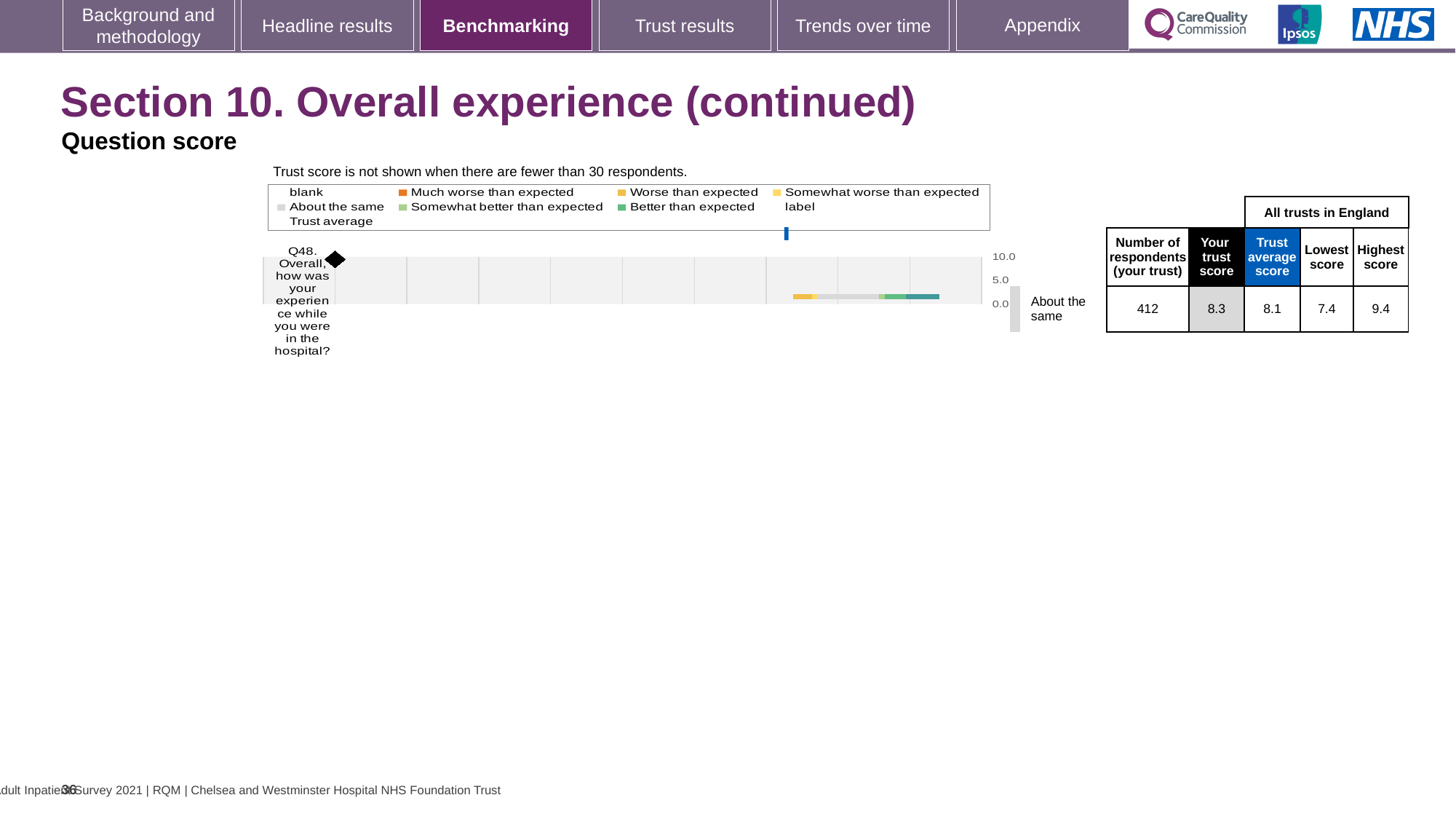
What is the difference between the trust score and the trust average score for Q48? 0.2 Which is larger for Q48, the trust score or the trust average score? trust score What is the lowest score across all trusts in England for Q48? 7.4 What is the difference between the highest score and the lowest score for Q48? 2.0 What kind of chart is shown for Q48 on the slide? bar chart What is the maximum value shown on the chart's score axis? 10.0 What benchmark category label is shown next to the Q48 bar? About the same What is the trust average score for Q48 shown in the table? 8.1 How many respondents from the trust answered Q48? 412 How many questions are plotted in the chart on the slide? 1 What is the trust score for Q48 shown in the table? 8.3 What is the highest score across all trusts in England for Q48? 9.4